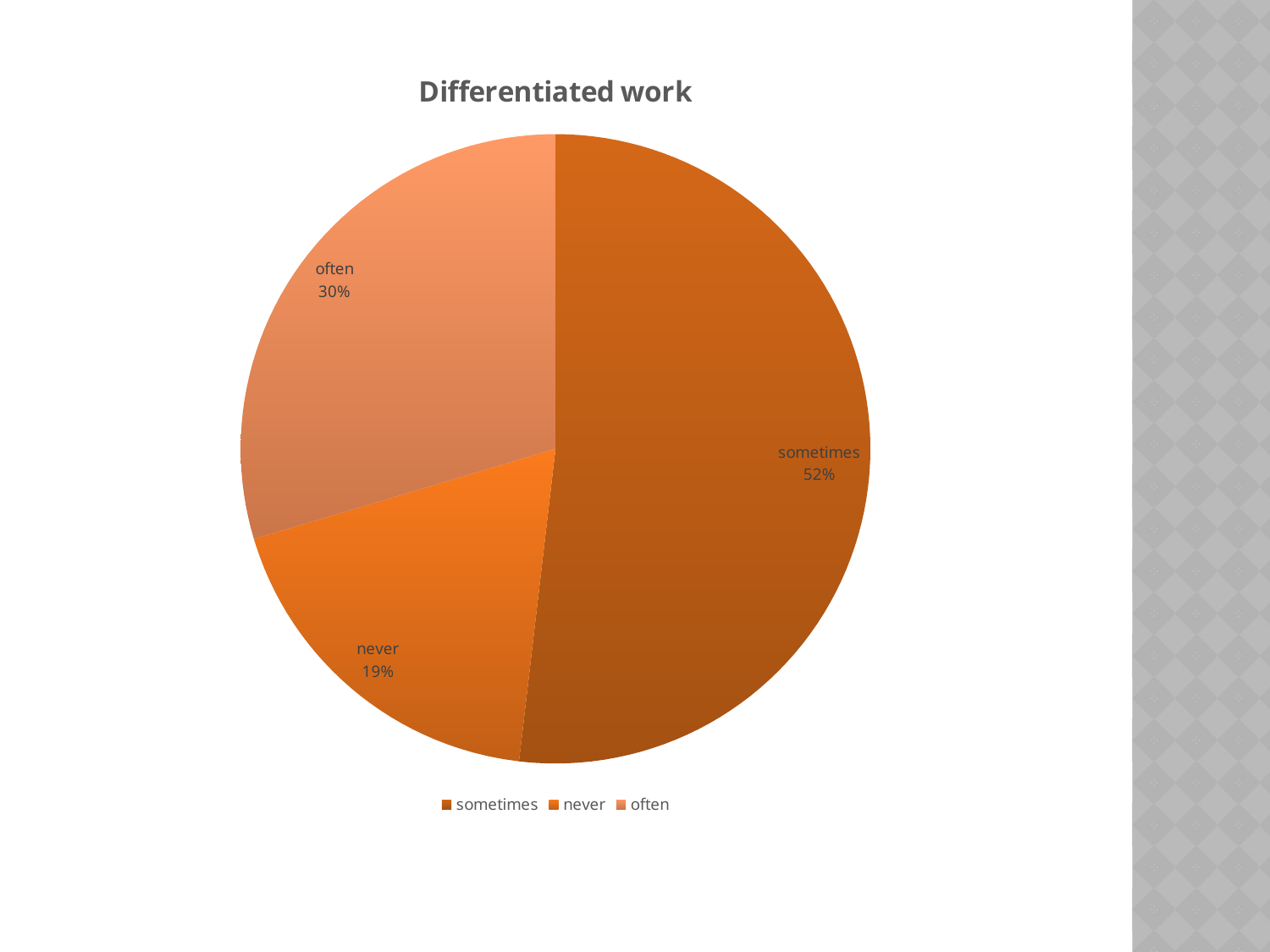
How many slices does the pie chart have? 3 What percentage of the pie is labelled "sometimes"? 52% What percentage of the pie is labelled "often"? 30% What kind of chart is shown on the slide? pie chart What is the difference in percentage points between the "sometimes" and "often" slices? 22 What is the title of the chart? Differentiated work What percentage of the pie is labelled "never"? 19% Which slice is larger, "often" or "never"? often Which category has the smallest share of the pie? never What is the combined share of the "never" and "often" slices? 49% Which category has the largest share of the pie? sometimes How many entries does the legend list? 3